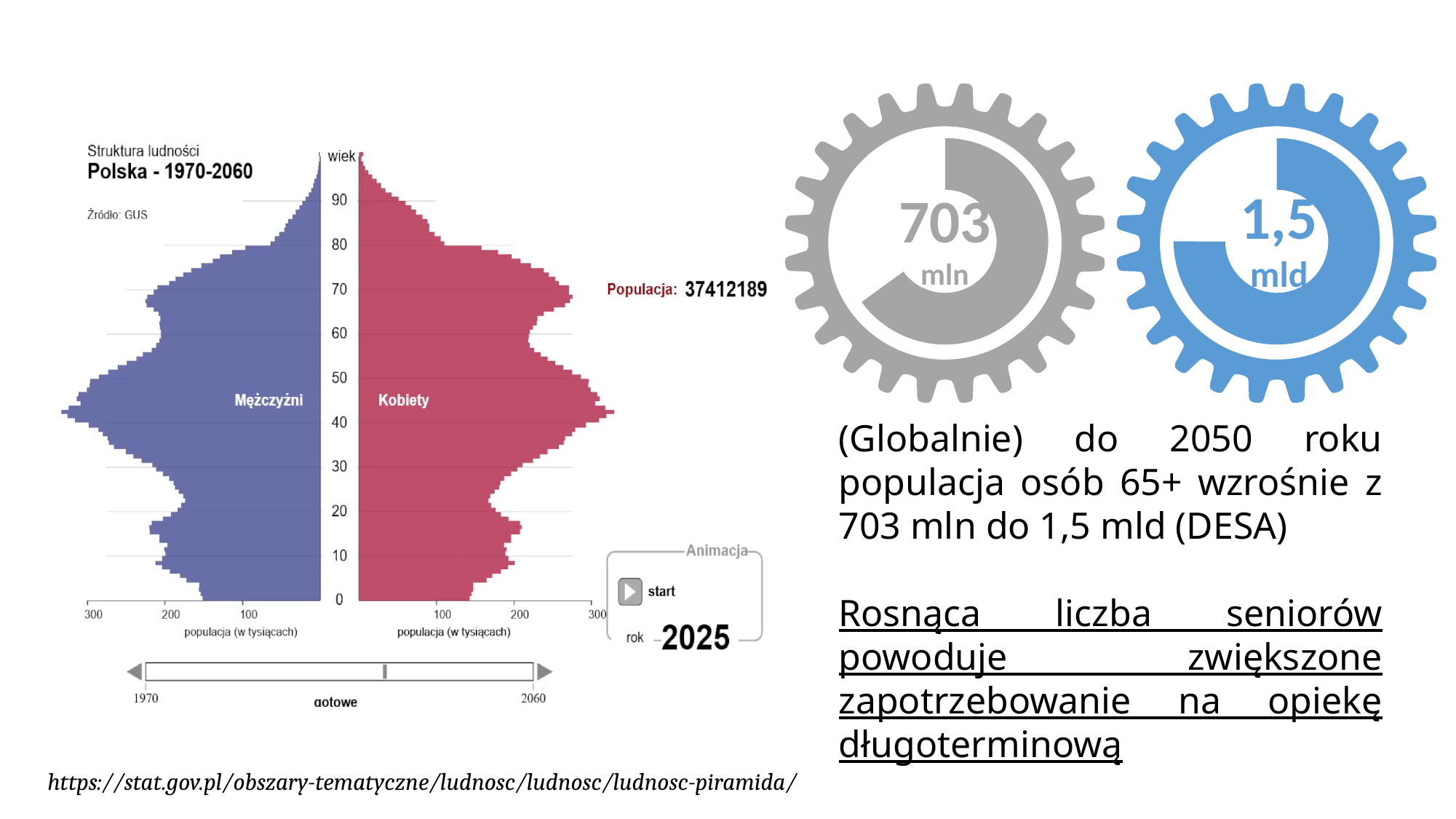
What total population value (Populacja) is printed next to the population pyramid chart? 37412189 What is the title of the population pyramid chart on the left of the slide? Struktura ludności Polska - 1970-2060 What value is shown in the blue gear infographic on the right of the slide? 1,5 mld What value is shown in the grey gear infographic on the right of the slide? 703 mln In the population pyramid chart, which series is plotted on the left side in blue-purple? Mężczyźni Which year (rok) is the population pyramid chart currently displaying? 2025 In the population pyramid chart, is the value for men (Mężczyźni) at around age 43 greater or less than 300 thousand? greater In the population pyramid chart, is the value for women (Kobiety) at around age 70 greater or less than 200 thousand? greater In the population pyramid chart, is the value for women (Kobiety) at age 0 greater or less than 200 thousand? less How many series (sexes) does the population pyramid chart show? 2 What kind of chart is the population structure chart on the left of the slide? bar chart